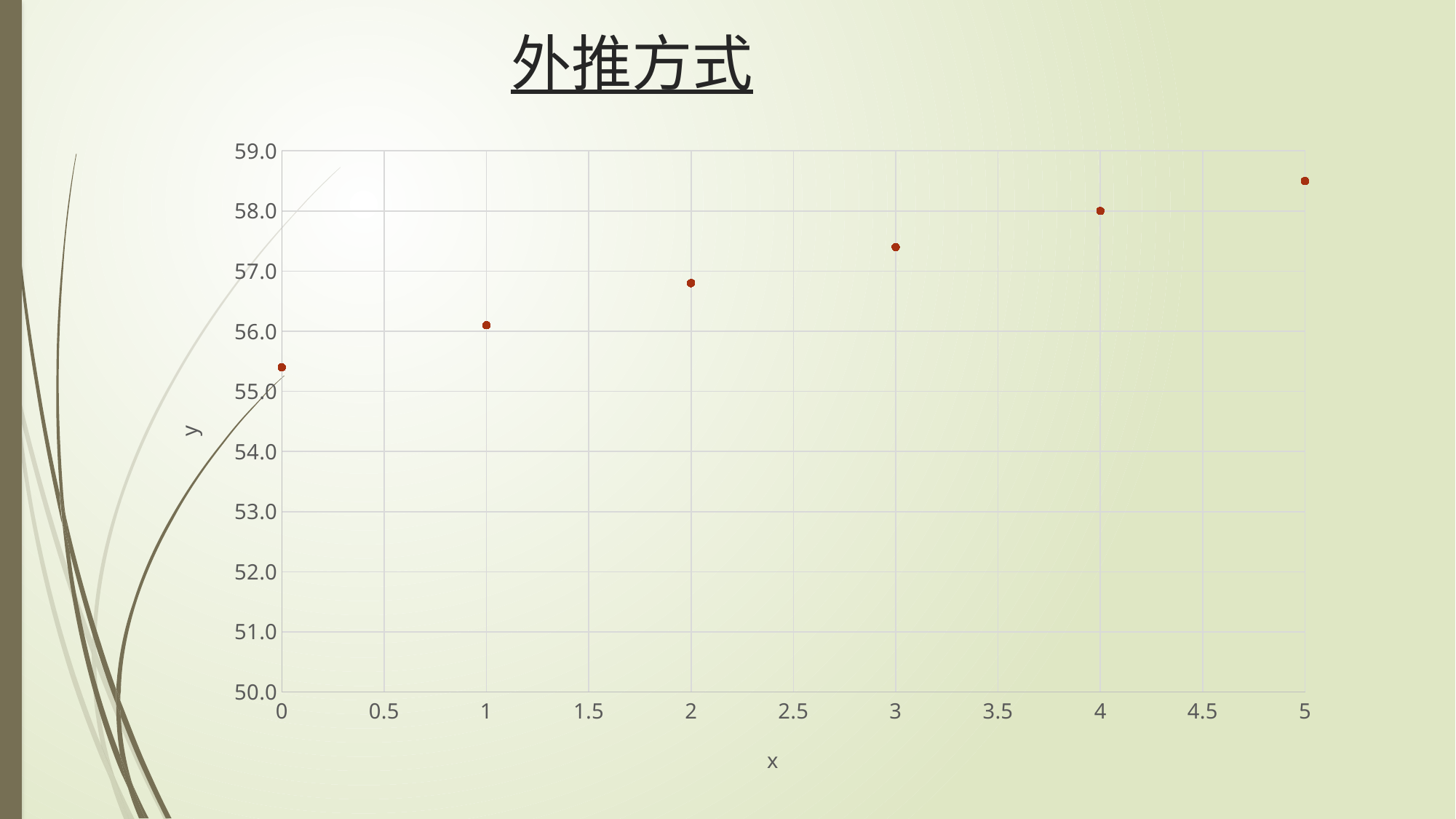
Is the y value at x = 0 greater or less than 56.0? less Do the y values rise or fall as x increases? rise At which x value is y the highest? 5 Is the y value at x = 3 greater or less than 57.0? greater Is the y value at x = 5 greater or less than 58.0? greater What is the y value at x = 4? 58.0 What kind of chart is shown on the slide? scatter chart What is the title of the slide containing the chart? 外推方式 How many data points are plotted on the chart? 6 At which x value is y the lowest? 0 Which has a larger y value, x = 1 or x = 3? x = 3